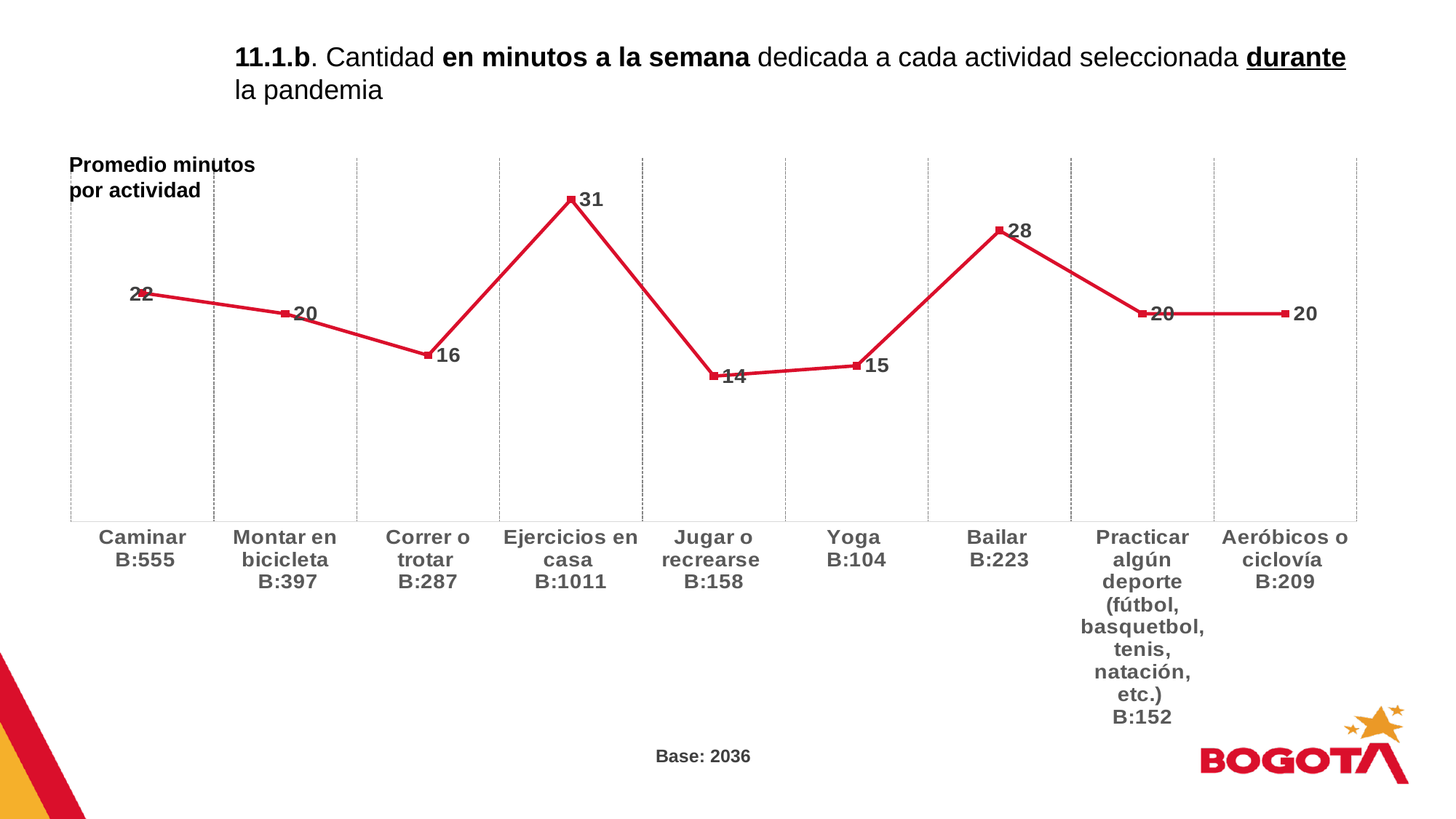
What is the average number of minutes per week for Ejercicios en casa? 31 How many activities are plotted on the chart? 9 What is the base (B) shown for Ejercicios en casa? B:1011 What is the average number of minutes per week for Yoga? 15 What is the average number of minutes per week for Jugar o recrearse? 14 What is the average number of minutes per week for Correr o trotar? 16 Which activity has the highest average minutes per week? Ejercicios en casa Which activity has the lowest average minutes per week? Jugar o recrearse What is the difference in average minutes between Ejercicios en casa and Bailar? 3 What is the average number of minutes per week for Bailar? 28 What kind of chart is shown on the slide? Line chart Which has a higher average minutes per week, Montar en bicicleta or Correr o trotar? Montar en bicicleta